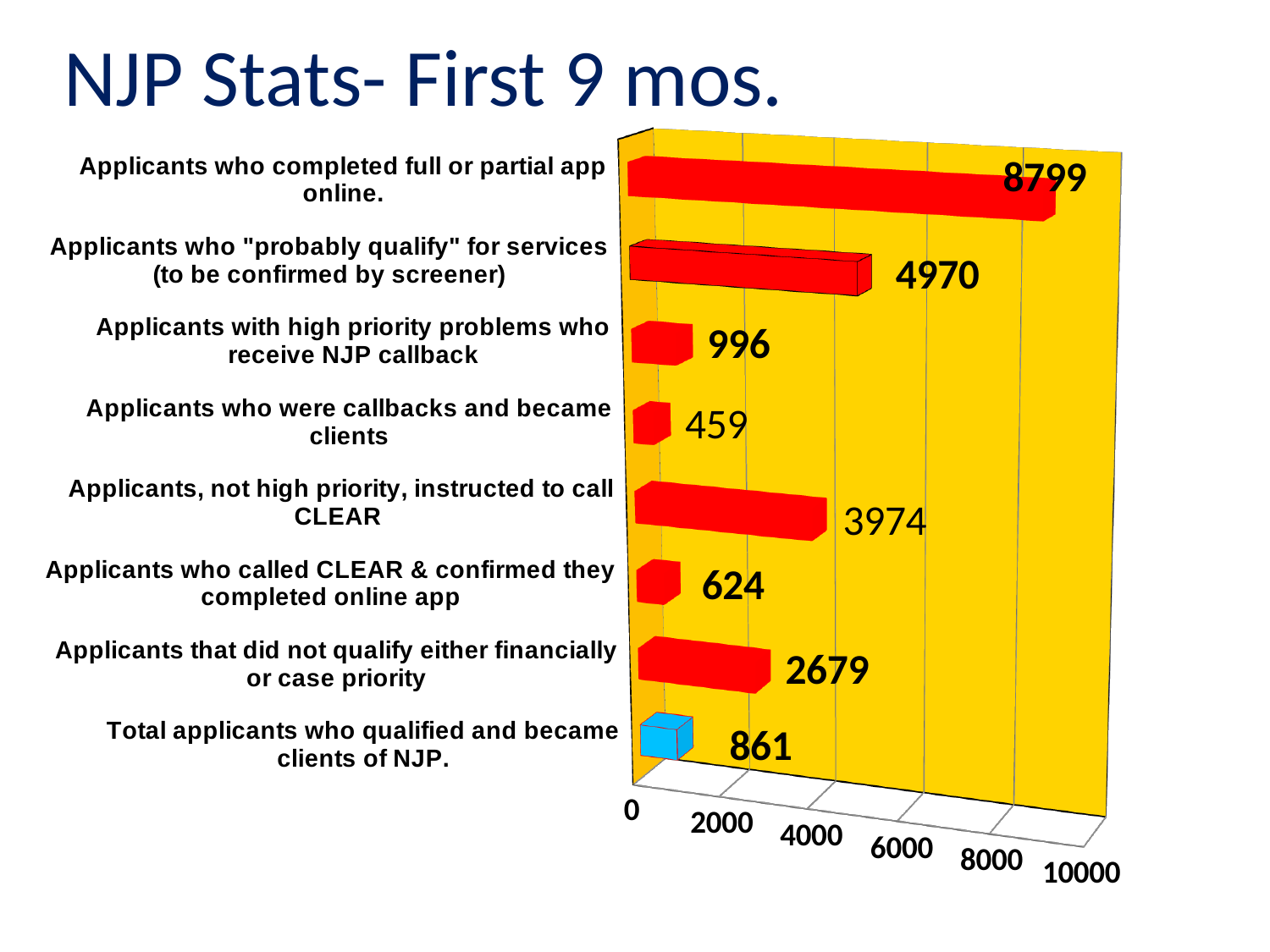
Is the value for 'Applicants with high priority problems who receive NJP callback' greater or less than 2000? less What is the value for 'Applicants who were callbacks and became clients'? 459 What is the title of the slide? NJP Stats- First 9 mos. What kind of chart is shown on the slide? bar chart What is the value for 'Total applicants who qualified and became clients of NJP.'? 861 Which category has the lowest value? Applicants who were callbacks and became clients What is the value for 'Applicants who completed full or partial app online.'? 8799 What is the difference between 'Applicants who completed full or partial app online.' and 'Applicants who "probably qualify" for services (to be confirmed by screener)'? 3829 How many categories are shown in the chart? 8 What is the value for 'Applicants who "probably qualify" for services (to be confirmed by screener)'? 4970 Which category has the highest value? Applicants who completed full or partial app online. Which is larger: 'Applicants, not high priority, instructed to call CLEAR' or 'Applicants that did not qualify either financially or case priority'? Applicants, not high priority, instructed to call CLEAR